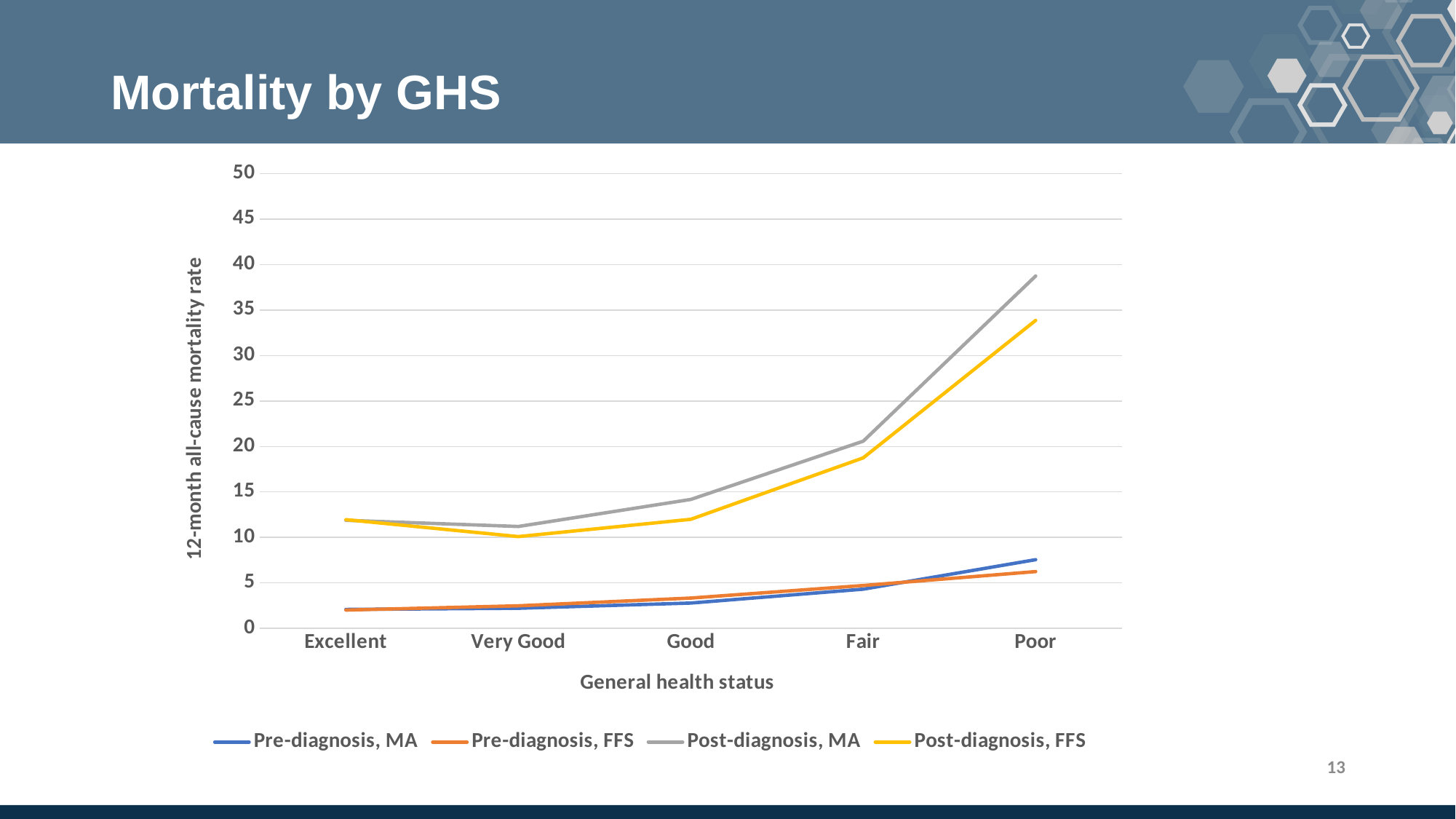
Is the Post-diagnosis, FFS value for Poor greater or less than 30? greater For the Poor category, which is larger: Pre-diagnosis, MA or Pre-diagnosis, FFS? Pre-diagnosis, MA Does the Post-diagnosis, MA line rise or fall from Good to Poor? rise Is the Post-diagnosis, FFS value for Fair greater or less than 20? less How many general health status categories are shown on the x axis? 5 How many series does the legend list? 4 What is the title of the y axis? 12-month all-cause mortality rate Which general health status has the lowest Post-diagnosis, FFS mortality rate? Very Good What kind of chart is shown on the slide? line chart Which general health status has the highest Post-diagnosis, MA mortality rate? Poor For the Poor category, which is larger: Post-diagnosis, MA or Post-diagnosis, FFS? Post-diagnosis, MA Is the Post-diagnosis, MA value for Poor greater or less than 35? greater